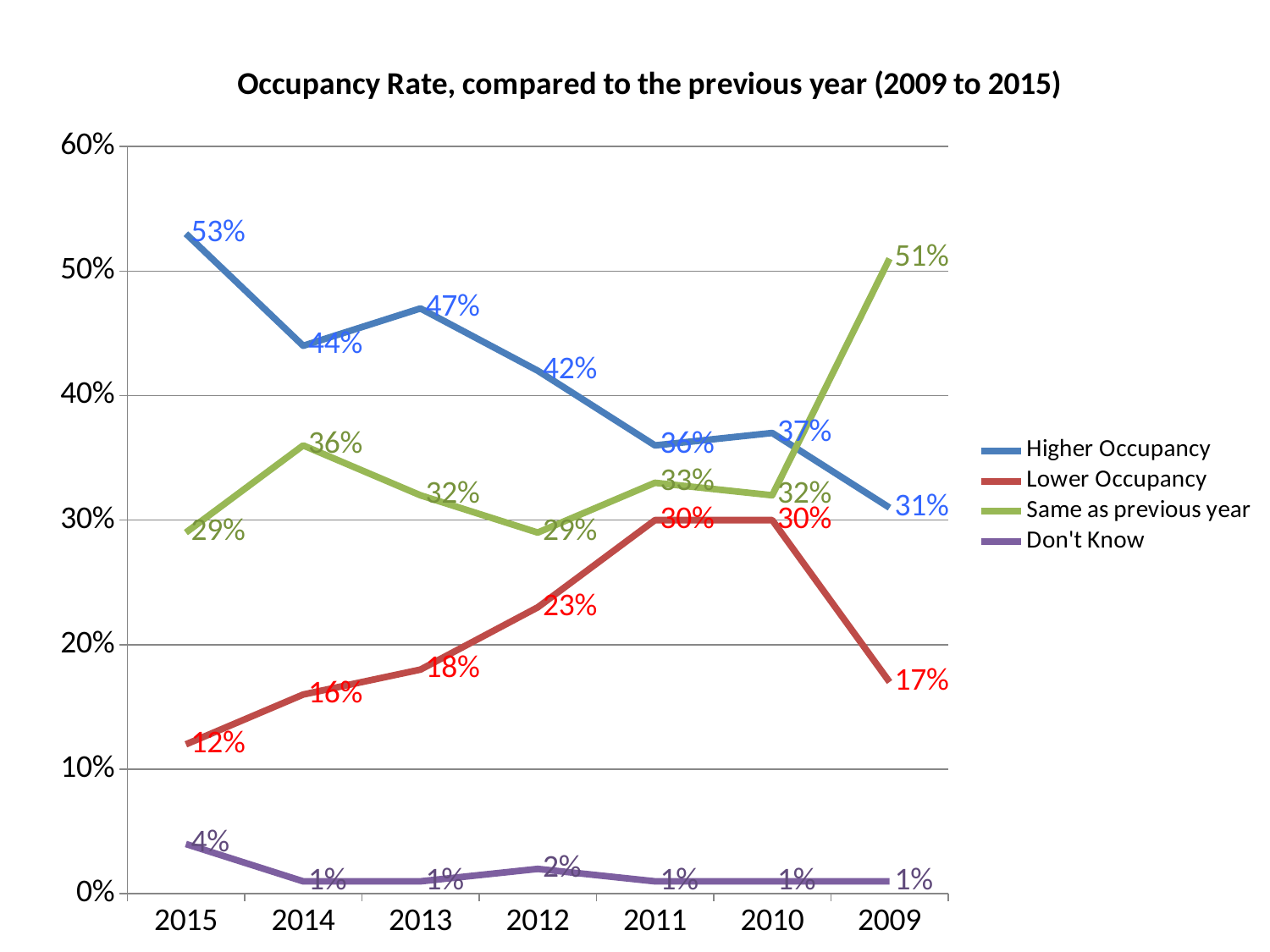
How many series does the legend list? 4 What is the Higher Occupancy value for 2015? 53% What kind of chart is this? Line chart Which is larger in 2009, Higher Occupancy or Same as previous year? Same as previous year What is the Don't Know value for 2015? 4% Does the Higher Occupancy series generally rise or fall from 2015 to 2009 along the x axis? Fall How many years are shown on the x axis? 7 What is the Same as previous year value for 2009? 51% What is the difference between the Higher Occupancy value and the Lower Occupancy value in 2013? 29% What is the Lower Occupancy value for 2012? 23% In which year is the Lower Occupancy series at its lowest? 2015 In which year is the Higher Occupancy series at its highest? 2015